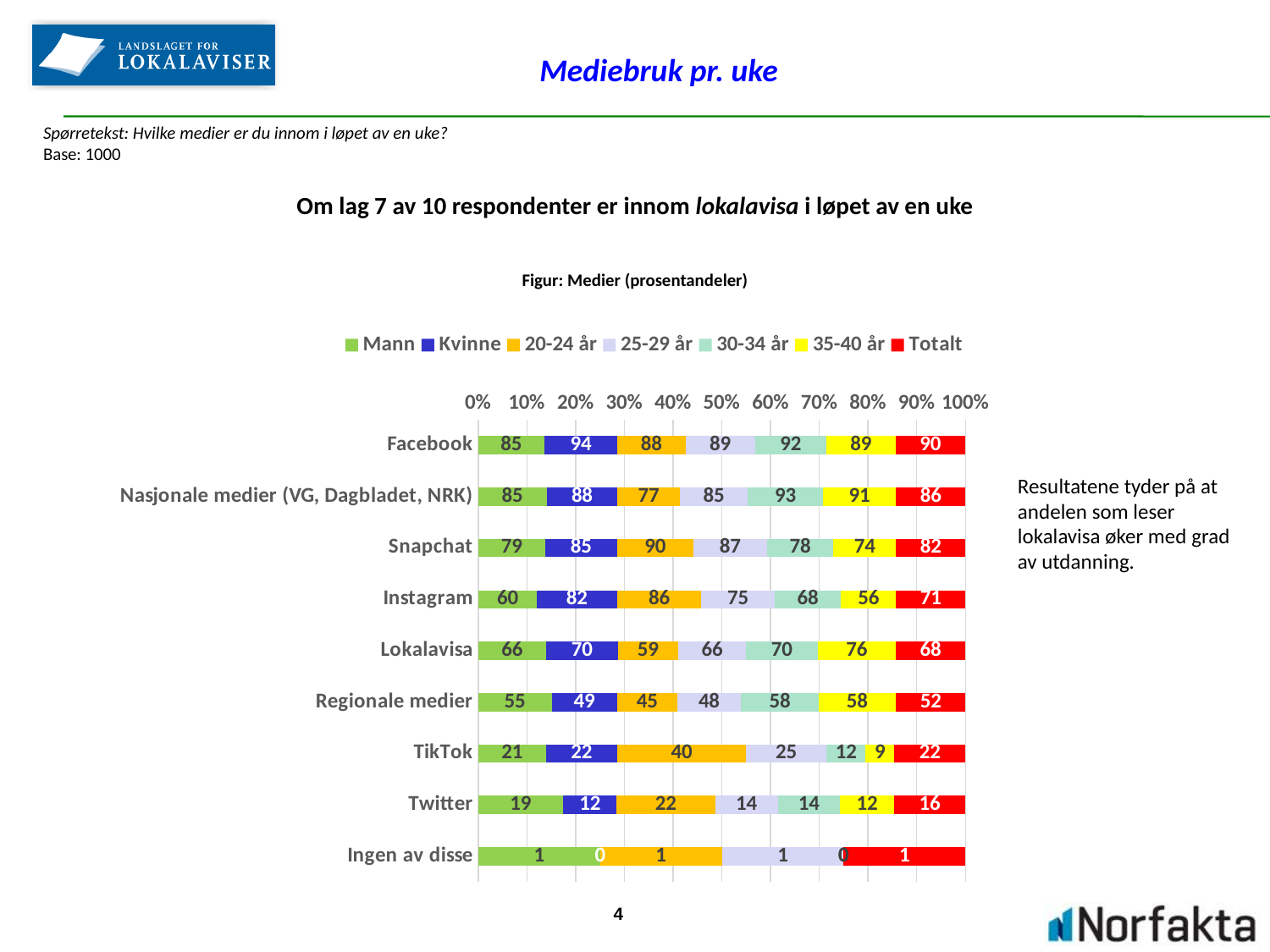
What is the difference between the Kvinne and Mann values for Instagram? 22 Which category has the lowest Totalt value? Ingen av disse Which category has the highest Totalt value? Facebook What colour represents the Totalt series in the chart? Red What is the Totalt value for Lokalavisa? 68 For Lokalavisa, which is larger: the 35-40 år value or the 20-24 år value? 35-40 år What is the Totalt value for Facebook? 90 What is the 20-24 år value for TikTok? 40 How many categories are shown on the chart? 9 What is the Mann value for Instagram? 60 What kind of chart is shown on the slide? Stacked bar chart How many series does the legend list? 7